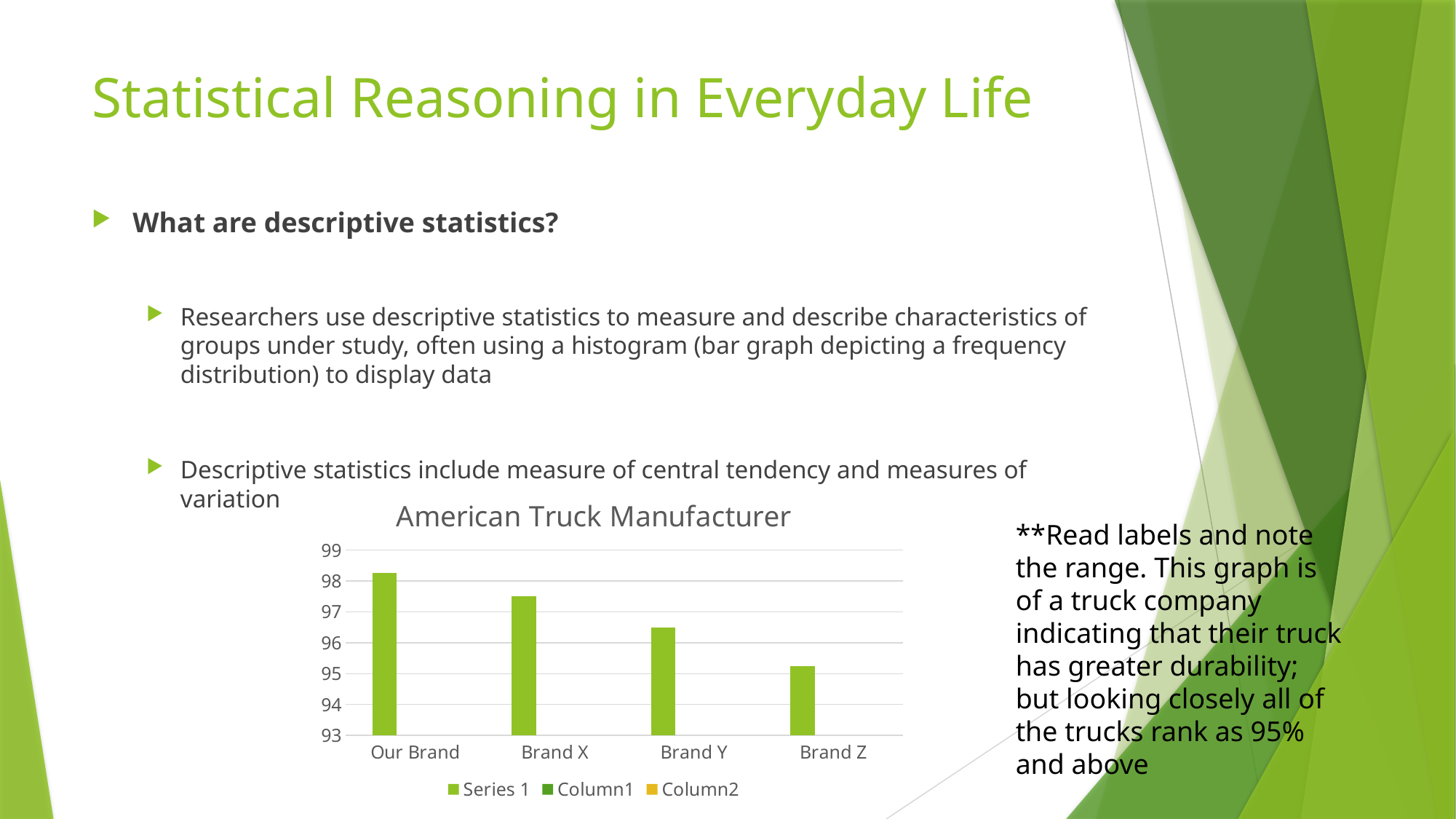
Do the bar values rise or fall from Our Brand to Brand Z along the x axis? fall How many categories are shown on the x axis of the chart? 4 Which is larger, the value for Our Brand or the value for Brand Z? Our Brand Is the value for Our Brand greater or less than 98? greater Is the value for Brand Y greater or less than 97? less Is the value for Brand Z greater or less than 96? less Which category has the highest bar in the chart? Our Brand How many series does the chart's legend list? 3 What type of chart is shown on the slide? bar chart Which category has the lowest bar in the chart? Brand Z Which is larger, the value for Brand X or the value for Brand Y? Brand X What is the title of the chart? American Truck Manufacturer